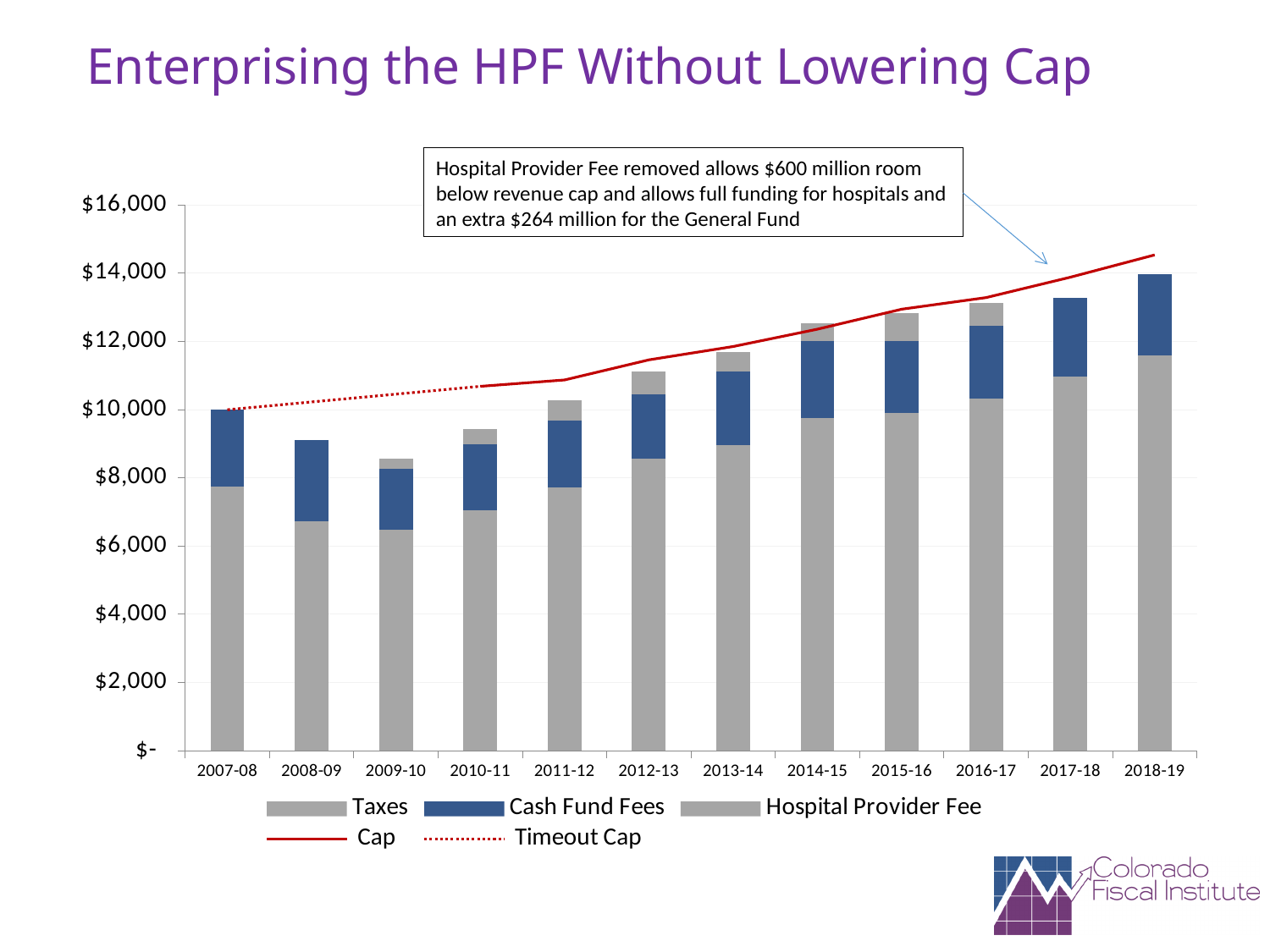
Is the total stacked bar for 2009-10 greater or less than $8,000? greater How many series does the chart's legend list? 5 Is the Taxes value for 2018-19 greater or less than $10,000? greater What is the title of the slide containing the chart? Enterprising the HPF Without Lowering Cap Which fiscal year has the lowest total stacked bar? 2009-10 Do the total stacked bars rise or fall from 2009-10 to 2018-19? rise What kind of chart is shown on the slide? Stacked bar chart with line series How many fiscal years are shown on the x axis of the chart? 12 Which has the larger total stacked bar, 2008-09 or 2009-10? 2008-09 Which fiscal year has the highest total stacked bar? 2018-19 Is the Cap line value for 2018-19 greater or less than $14,000? greater